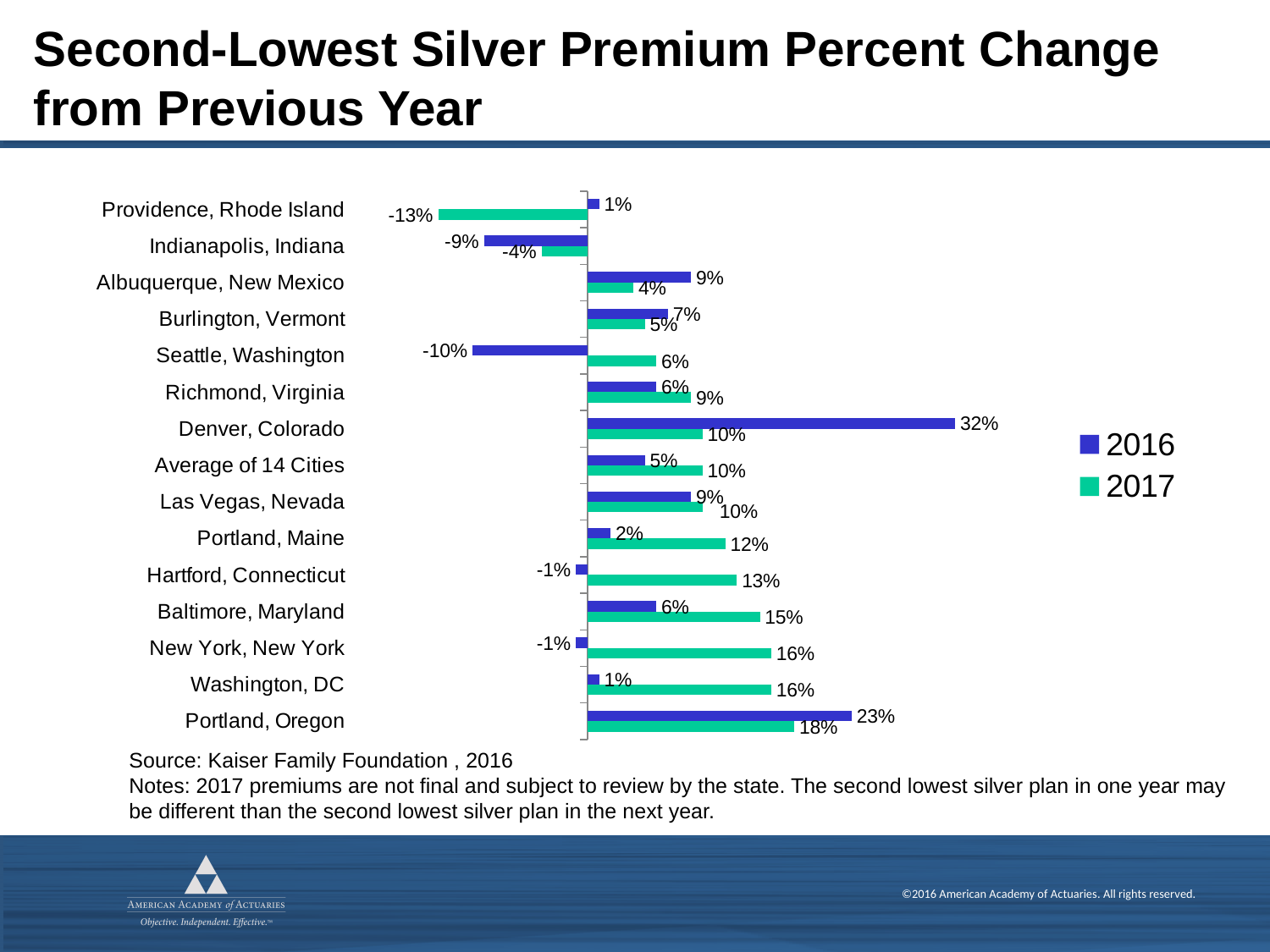
What is the 2017 percent change for Providence, Rhode Island? -13% How many categories (cities/averages) are plotted on the chart? 15 What is the 2016 percent change for Seattle, Washington? -10% Which colour represents the 2017 series in the legend? Green What is the 2016 percent change for Denver, Colorado? 32% What is the difference between the 2016 and 2017 values for Denver, Colorado? 22 percentage points What is the 2017 value for the Average of 14 Cities? 10% Which category has the lowest 2017 value? Providence, Rhode Island Which category has the highest 2016 value? Denver, Colorado What kind of chart is shown on the slide? Bar chart For Seattle, Washington, which year has the larger value, 2016 or 2017? 2017 How many series does the legend list? 2